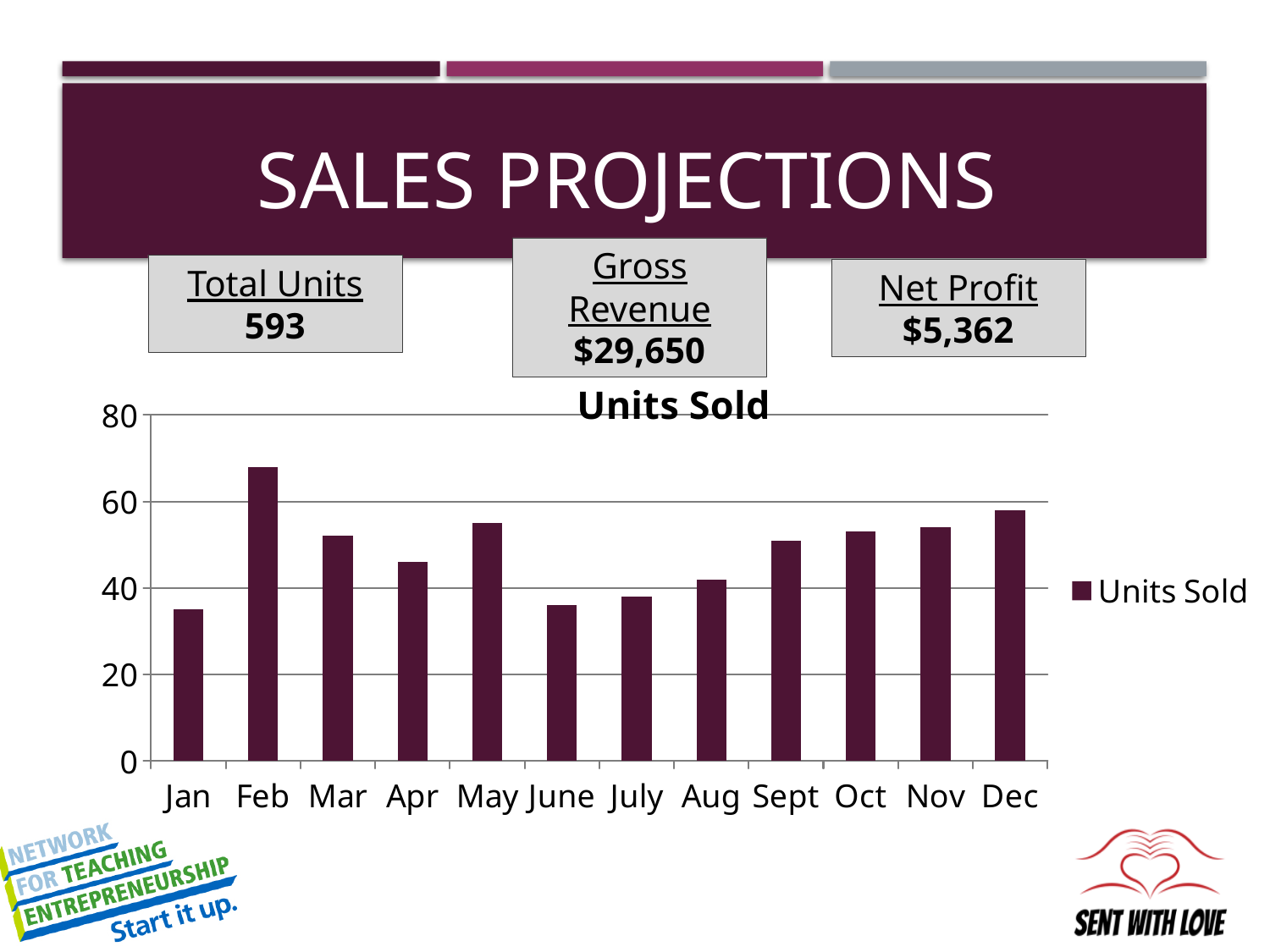
Which is larger, the units sold in Feb or in Jan? Feb Which month has the highest units sold? Feb Is the value for Mar greater or less than 40? greater What kind of chart is shown on the slide? bar chart Do the units sold rise or fall from June through Dec? rise Is the value for Feb greater or less than 60? greater Is the value for June greater or less than 40? less How many series does the chart legend list? 1 Which is larger, the units sold in Dec or in Apr? Dec How many months are shown on the x axis of the chart? 12 What is the title of the chart? Units Sold